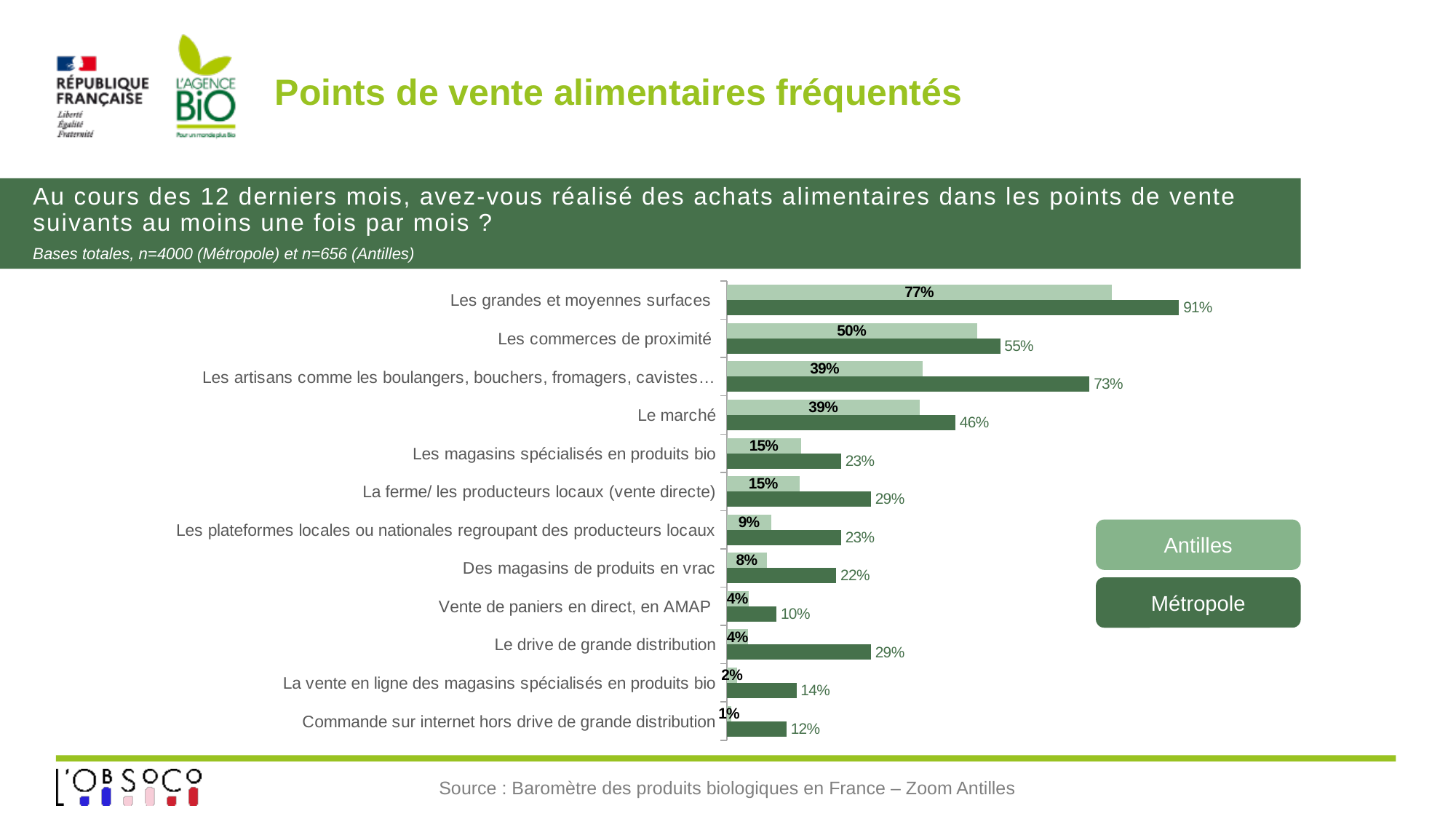
How many categories are shown in the chart? 12 What is the difference between the Métropole and Antilles values for "Les artisans comme les boulangers, bouchers, fromagers, cavistes…"? 34 percentage points What is the difference between the Métropole and Antilles values for "Les commerces de proximité"? 5 percentage points Which series is shown in the darker green colour? Métropole How many series does the legend list? 2 What is the Antilles value for "Les grandes et moyennes surfaces"? 77% What kind of chart is shown on the slide? Bar chart What is the Métropole value for "Les artisans comme les boulangers, bouchers, fromagers, cavistes…"? 73% What is the Métropole value for "Le drive de grande distribution"? 29% Which category has the lowest Antilles value? Commande sur internet hors drive de grande distribution Which is larger for "Le marché": the Antilles value or the Métropole value? Métropole Which category has the highest Métropole value? Les grandes et moyennes surfaces